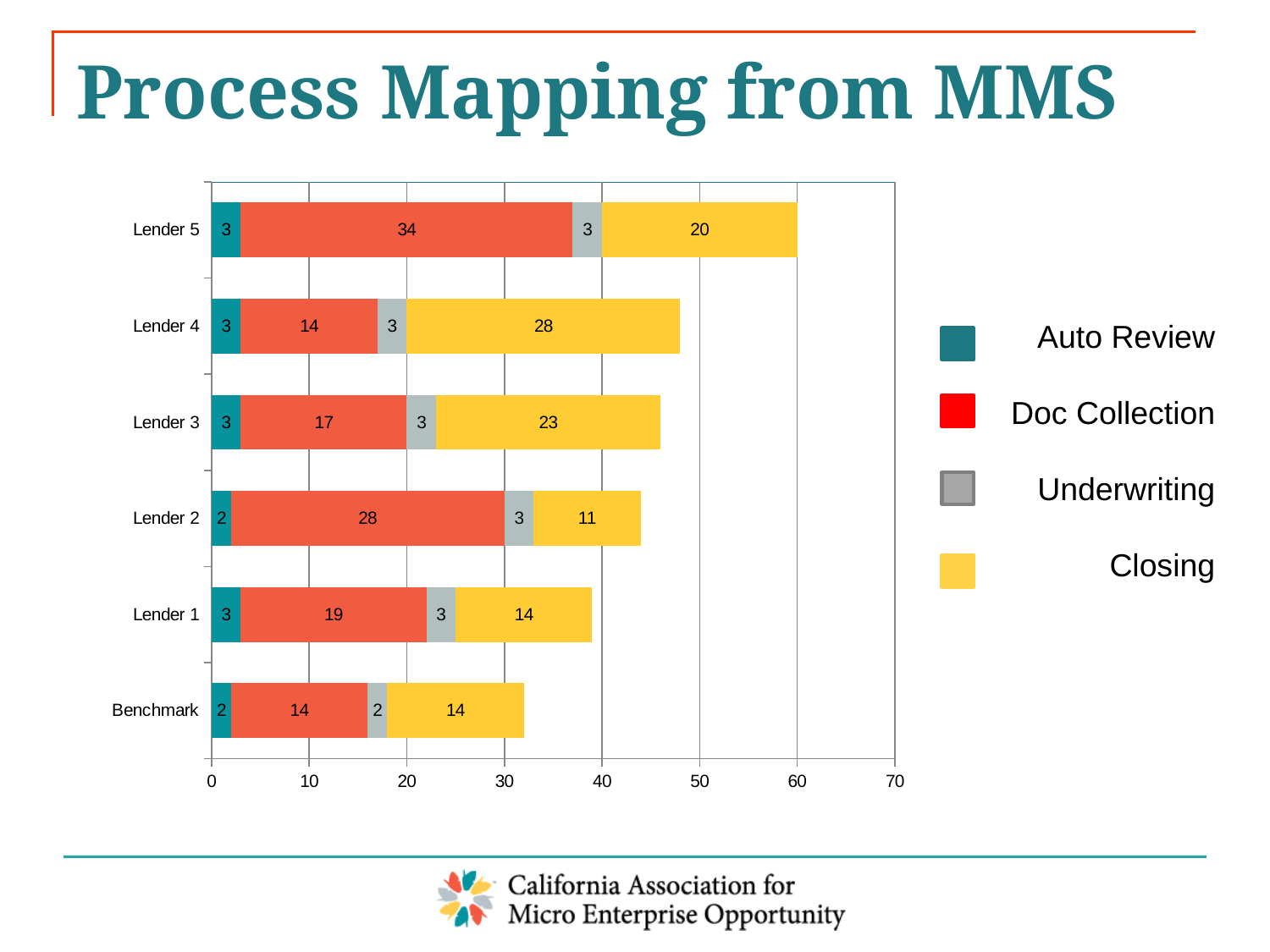
Which is larger, the Doc Collection value for Lender 2 or for Lender 3? Lender 2 What is the Underwriting value for Benchmark? 2 What is the difference between the Closing values for Lender 4 and Lender 2? 17 What kind of chart is shown on the slide? Stacked bar chart Which category has the lowest Closing value? Lender 2 How many categories are plotted on the chart? 6 What is the Doc Collection value for Lender 5? 34 What is the total of the stacked bar for Lender 5? 60 What is the Closing value for Lender 4? 28 Which category has the highest Doc Collection value? Lender 5 How many series does the legend list? 4 What is the total of the stacked bar for Benchmark? 32